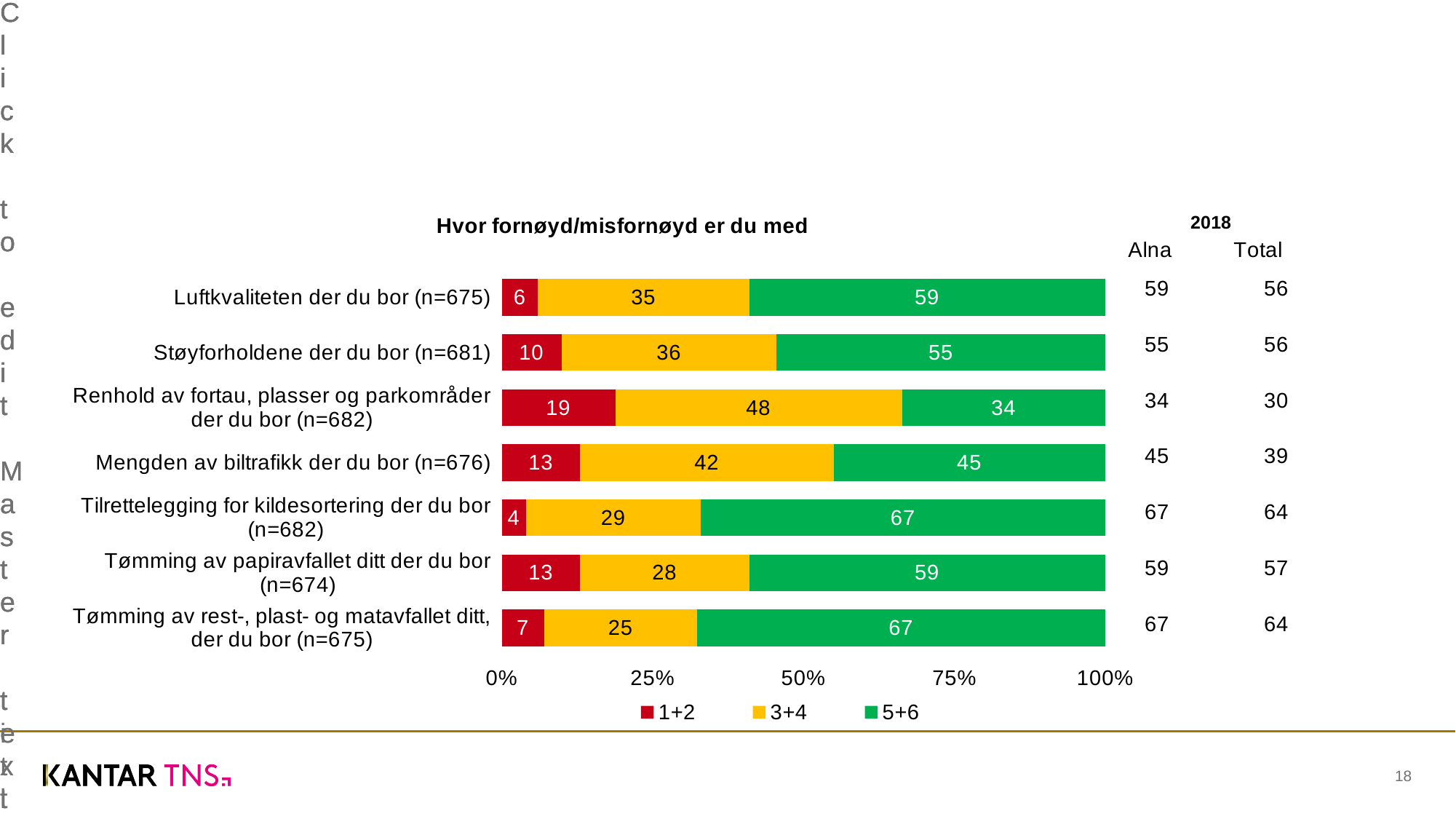
What is the title of the chart? Hvor fornøyd/misfornøyd er du med Which has the larger 1+2 value: "Støyforholdene der du bor (n=681)" or "Luftkvaliteten der du bor (n=675)"? Støyforholdene der du bor (n=681) What is the value of the 5+6 series for "Luftkvaliteten der du bor (n=675)"? 59 How many categories are shown in the chart? 7 Which category has the lowest value in the 1+2 series? Tilrettelegging for kildesortering der du bor (n=682) What is the value of the 1+2 series for "Renhold av fortau, plasser og parkområder der du bor (n=682)"? 19 What kind of chart is shown on the slide? Stacked bar chart How many series does the legend list? 3 Which category has the lowest value in the 3+4 series? Tømming av rest-, plast- og matavfallet ditt, der du bor (n=675) What is the difference between the 5+6 values for "Luftkvaliteten der du bor (n=675)" and "Støyforholdene der du bor (n=681)"? 4 What is the value of the 3+4 series for "Mengden av biltrafikk der du bor (n=676)"? 42 Which category has the highest value in the 1+2 series? Renhold av fortau, plasser og parkområder der du bor (n=682)